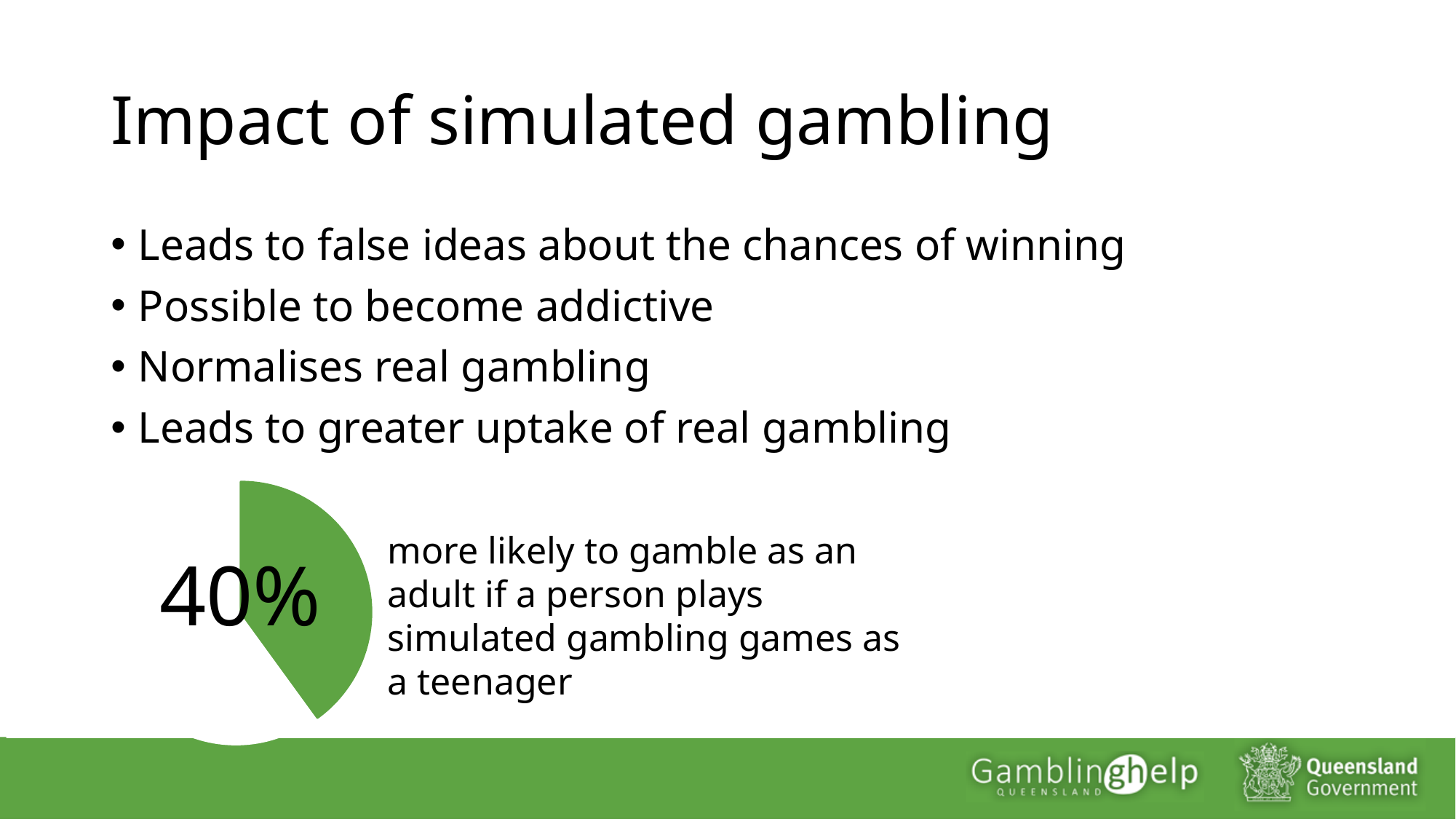
What colour is the highlighted slice of the pie chart? green Is the value shown on the pie chart greater or less than 50%? less Is the value shown on the pie chart greater or less than 25%? greater What kind of chart is shown on the slide? pie chart According to the text next to the pie chart, what does the 40% figure describe? more likely to gamble as an adult if a person plays simulated gambling games as a teenager What share of the pie does the green slice represent? 40% What percentage is shown on the pie chart? 40%